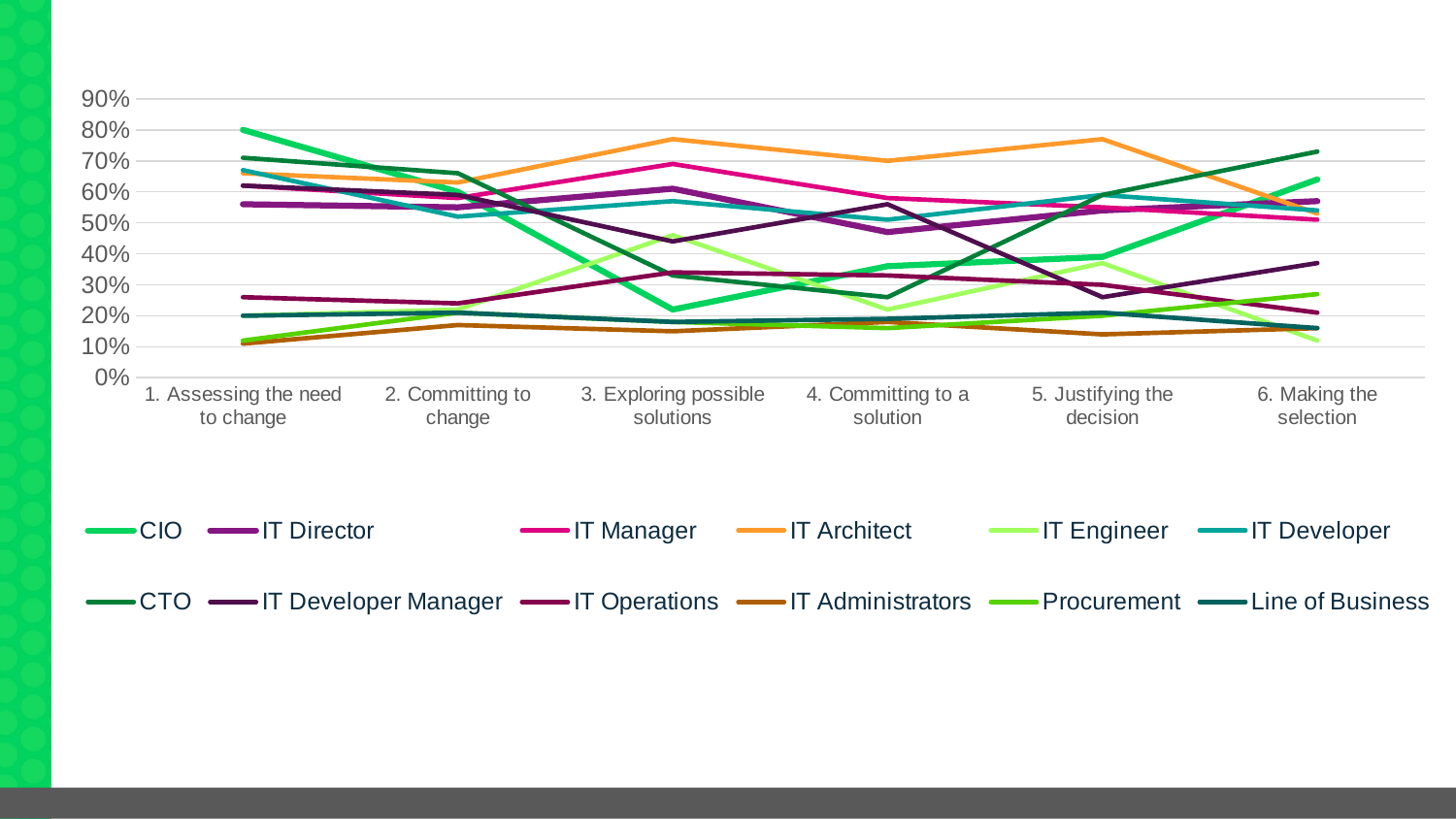
Is the value for IT Engineer at stage 6, Making the selection, greater or less than 20%? less Which series has the highest value at stage 1, Assessing the need to change? CIO How many series does the legend list? 12 Is the value for CIO at stage 1, Assessing the need to change, greater or less than 70%? greater Which series has the highest value at stage 3, Exploring possible solutions? IT Architect Is the value for IT Administrators at stage 1, Assessing the need to change, greater or less than 20%? less What kind of chart is shown on the slide? Line chart At stage 4, Committing to a solution, which is larger: IT Architect or IT Engineer? IT Architect Does the CIO line rise or fall from stage 1 to stage 3? Fall Which series has the highest value at stage 5, Justifying the decision? IT Architect How many stages (categories) are shown along the x axis? 6